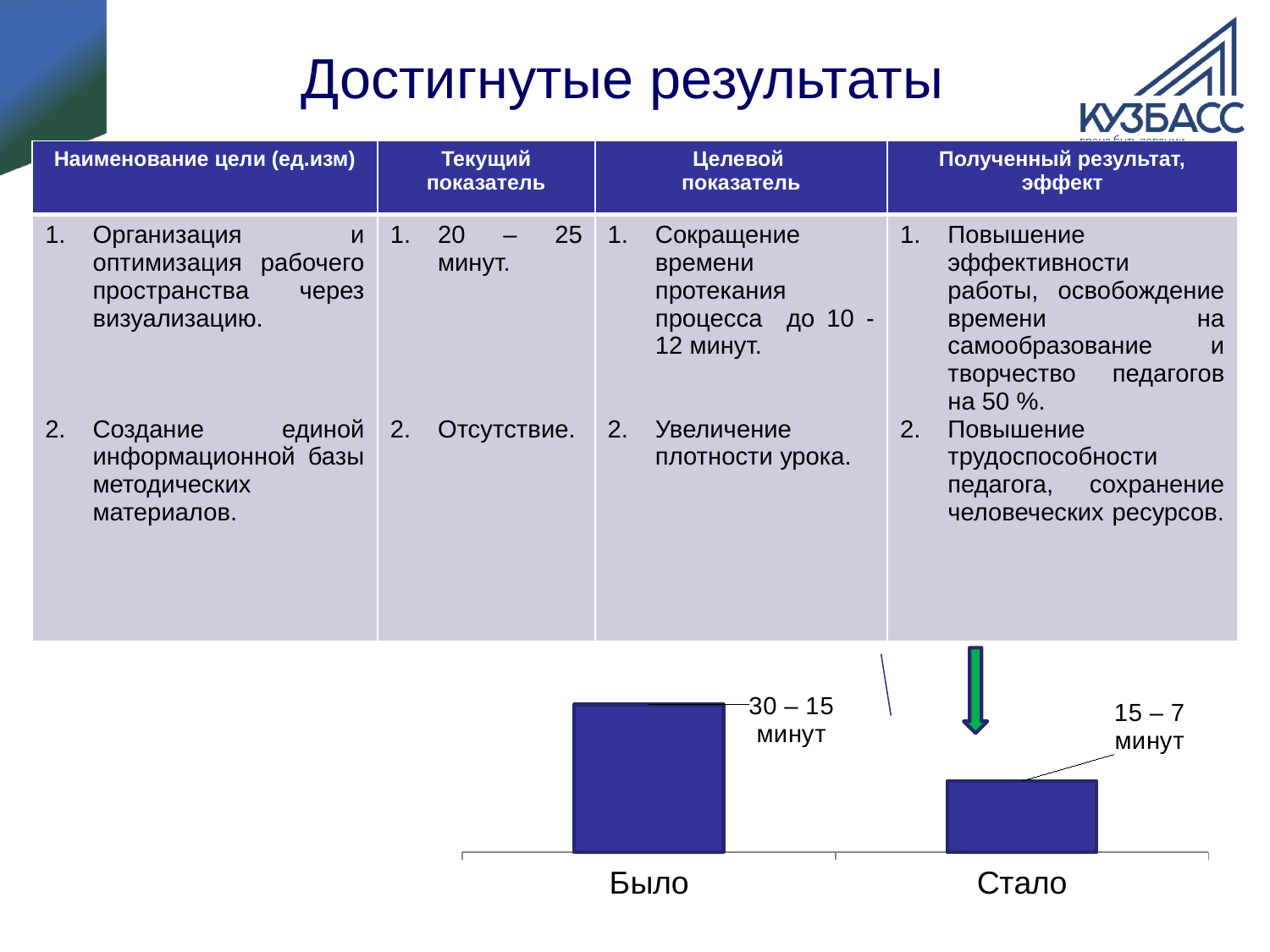
What label is attached to the Было bar in the chart? 30 – 15 минут What colour are the bars in the chart? dark blue What are the two category labels on the x axis of the chart? Было, Стало Do the bar values rise or fall from Было to Стало? fall What label is attached to the Стало bar in the chart? 15 – 7 минут Is the bar for Было larger or smaller than the bar for Стало? larger How many bars does the chart at the bottom of the slide have? 2 Which category has the shorter bar in the chart? Стало What kind of chart is shown at the bottom of the slide? bar chart Which category has the taller bar in the chart, Было or Стало? Было